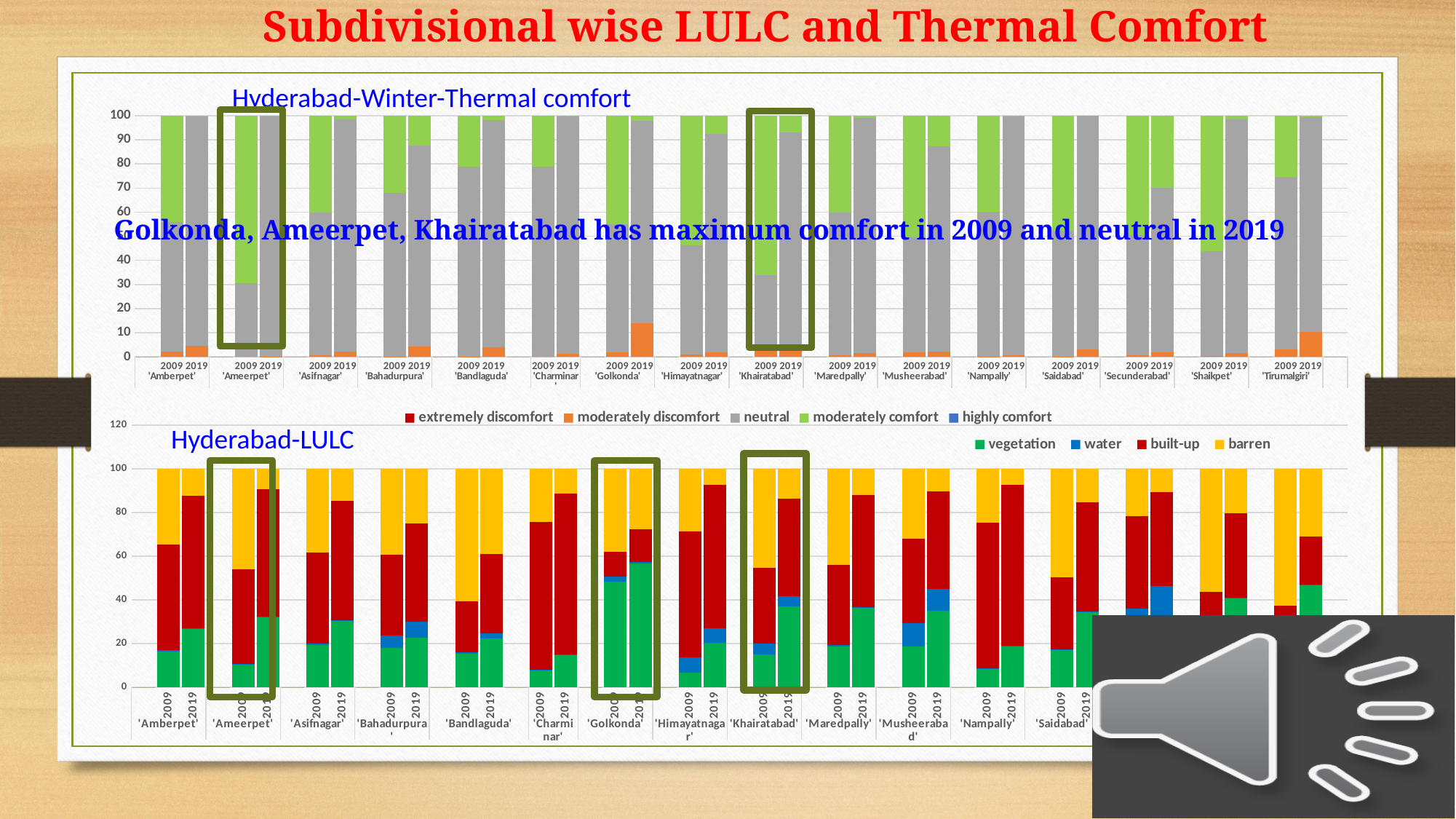
What kind of chart is the Hyderabad-Winter-Thermal comfort chart? Stacked bar chart How many series does the legend of the Hyderabad-LULC chart list? 4 In the Hyderabad-LULC chart, which has the larger vegetation share in 2009: Golkonda or Ameerpet? Golkonda In the Hyderabad-Winter-Thermal comfort chart, is the moderately discomfort share for Golkonda in 2019 greater or less than 10? greater How many subdivisions are shown on the x axis of the Hyderabad-Winter-Thermal comfort chart? 16 In the Hyderabad-LULC chart, is the vegetation share for Ameerpet in 2009 greater or less than 20? less In the Hyderabad-Winter-Thermal comfort chart, is the neutral share for Khairatabad in 2019 greater or less than 80? greater How many series does the legend of the Hyderabad-Winter-Thermal comfort chart list? 5 Which series in the Hyderabad-LULC chart is shown in yellow? barren In the Hyderabad-LULC chart, does the vegetation share for Ameerpet rise or fall from 2009 to 2019? rise